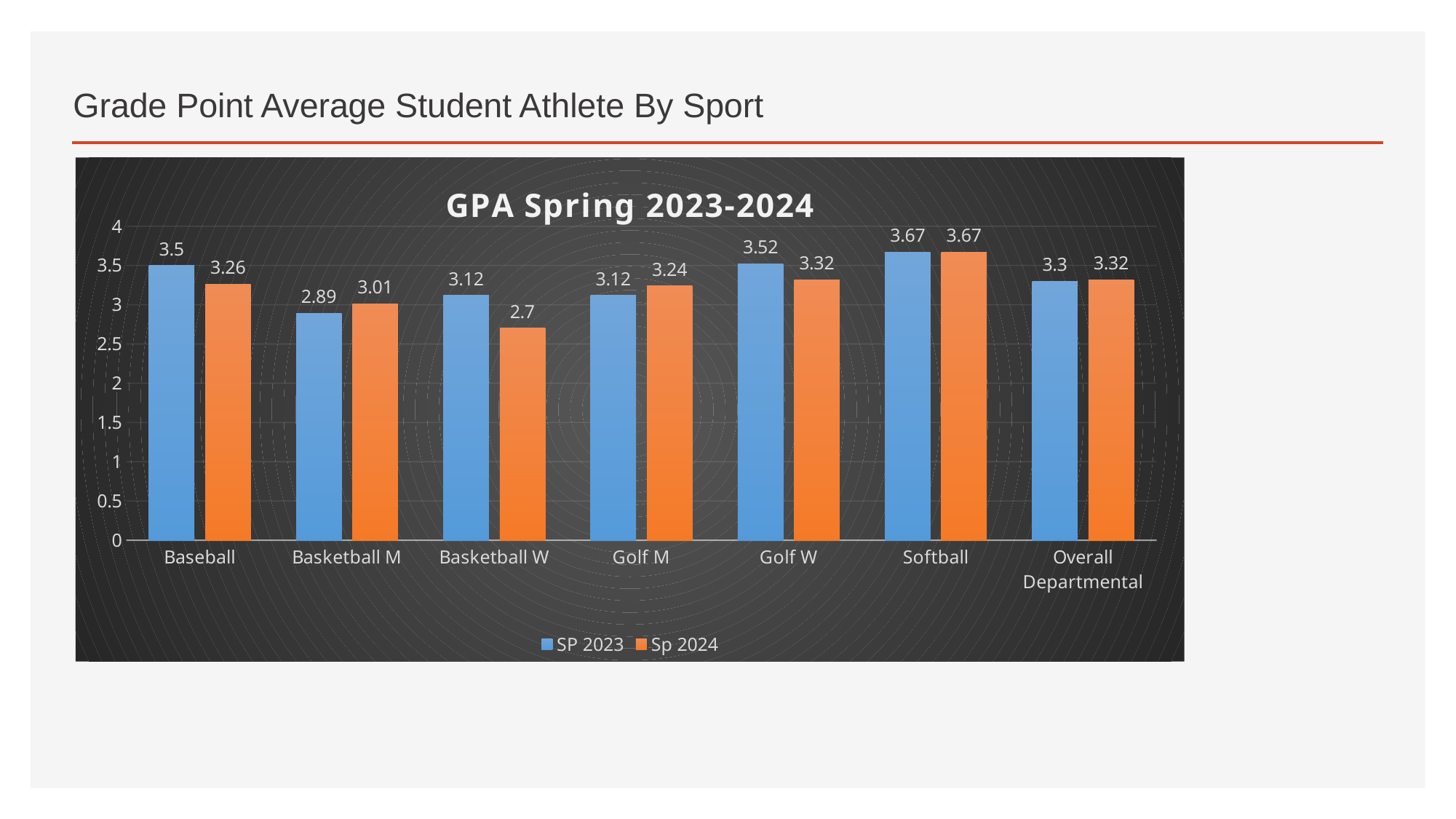
How many sport categories are shown on the x axis? 7 What is the Sp 2024 GPA for Overall Departmental? 3.32 Which colour represents the Sp 2024 series? Orange What is the difference between the SP 2023 and Sp 2024 GPA for Basketball W? 0.42 How many series does the legend list? 2 What kind of chart is shown? Bar chart Which sport has the lowest Sp 2024 GPA? Basketball W What is the Sp 2024 GPA for Basketball W? 2.7 What is the title of the chart? GPA Spring 2023-2024 What is the SP 2023 GPA for Baseball? 3.5 Which is larger for Golf M: the SP 2023 GPA or the Sp 2024 GPA? Sp 2024 Which sport has the highest SP 2023 GPA? Softball